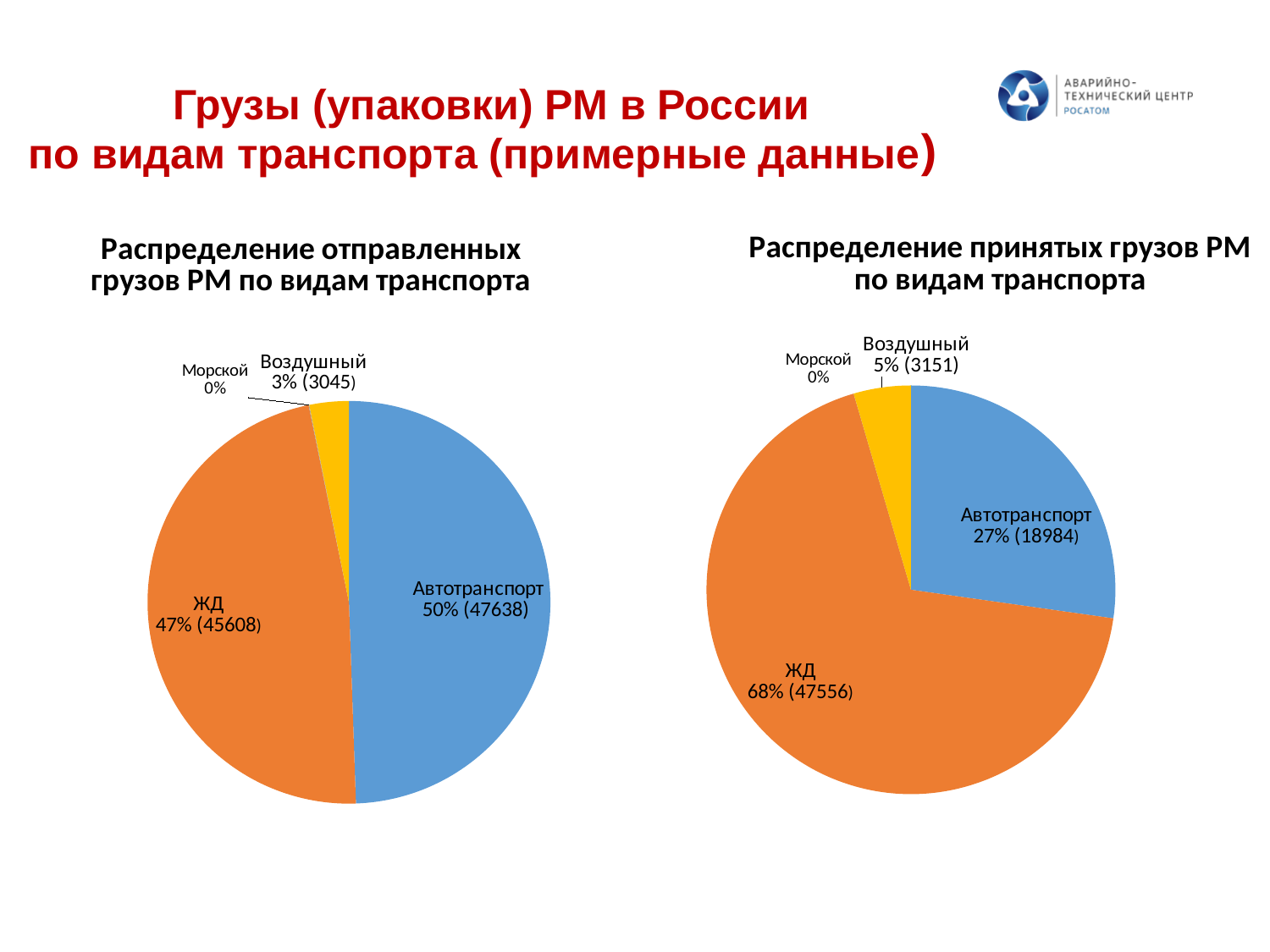
How many categories are shown in the left chart (отправленных грузов)? 4 In the left chart (отправленных грузов), what is the difference between the Автотранспорт value and the ЖД value? 2030 In the right chart (принятых грузов), which category has the largest slice? ЖД In the right chart (принятых грузов), what is the value shown for Воздушный? 3151 What kind of chart is the left chart, 'Распределение отправленных грузов РМ по видам транспорта'? pie chart In the left chart (отправленных грузов), which category has the largest slice? Автотранспорт In the left chart (отправленных грузов), which category has the smallest slice? Морской In the left chart (отправленных грузов), what share does Автотранспорт have? 50% In the right chart (принятых грузов), what is the difference between the ЖД value and the Автотранспорт value? 28572 In the right chart (принятых грузов), what share does ЖД have? 68% In the right chart (принятых грузов), which is larger, Автотранспорт or Воздушный? Автотранспорт In the left chart (отправленных грузов), what is the value shown for ЖД? 45608